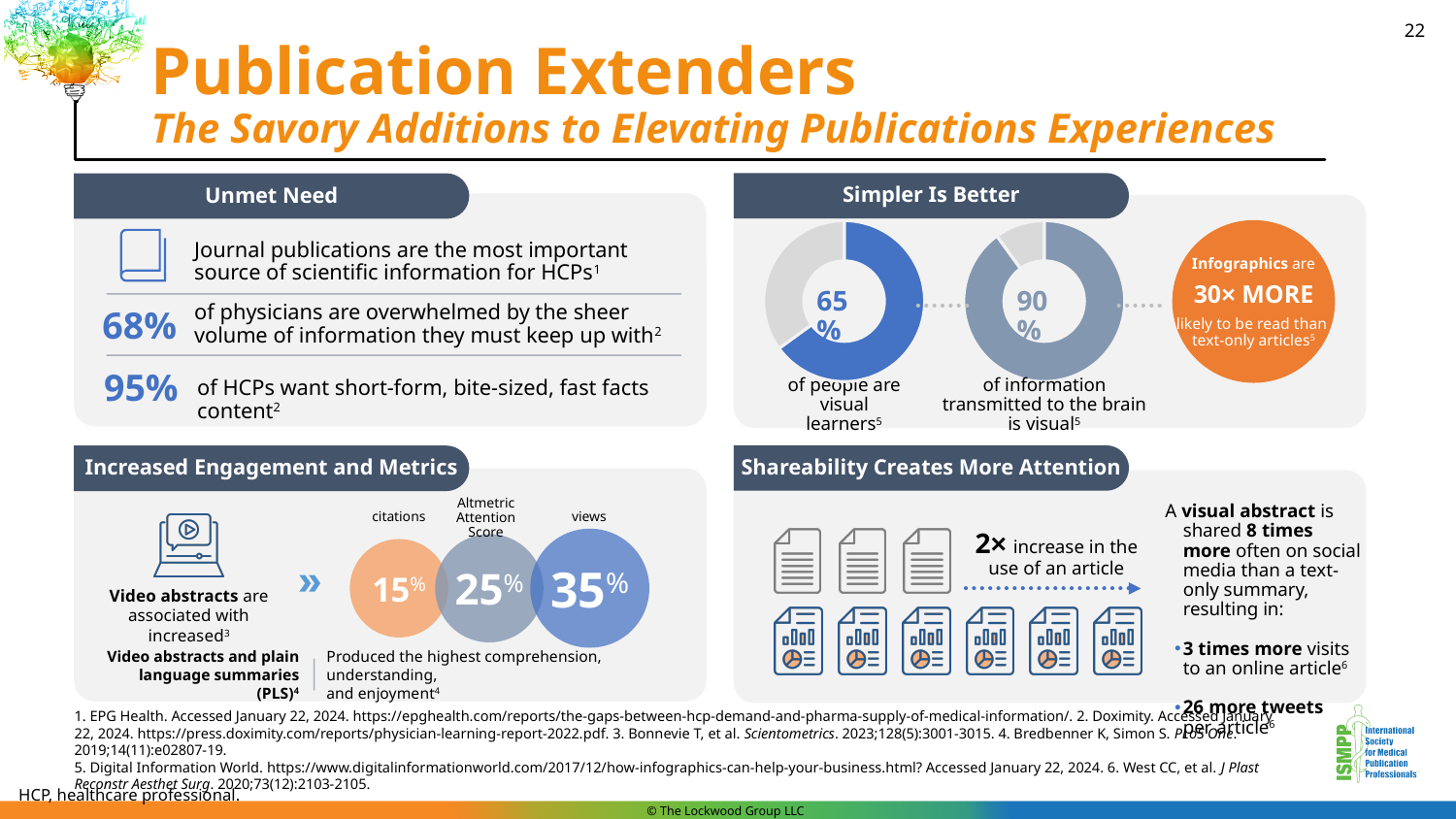
In the 'Increased Engagement and Metrics' section, what percentage increase in citations is shown in the circle chart? 15% In the 'Simpler Is Better' section, what share of the left donut chart is filled in blue? 65% In the 'Increased Engagement and Metrics' section, which metric shows the lowest percentage increase? Citations (15%) In the 'Simpler Is Better' section, what is the difference between the value in the right donut chart (90%) and the left donut chart (65%)? 25% In the 'Increased Engagement and Metrics' section, what is the difference between the percentage increase for views and for citations? 20% In the 'Increased Engagement and Metrics' section, which metric shows the highest percentage increase: citations, Altmetric Attention Score, or views? Views (35%) In the 'Increased Engagement and Metrics' section, what percentage increase in Altmetric Attention Score is shown? 25% What kind of chart is used to show the 65% and 90% values in the 'Simpler Is Better' section? Donut (pie) chart In the 'Simpler Is Better' section, what percentage of people are visual learners according to the left donut chart? 65% In the 'Simpler Is Better' section, which donut chart shows the larger value: the one for visual learners or the one for information transmitted to the brain? Information transmitted to the brain (90%) How many donut charts are shown in the 'Simpler Is Better' section? 2 In the 'Simpler Is Better' section, what percentage of information transmitted to the brain is visual according to the right donut chart? 90%